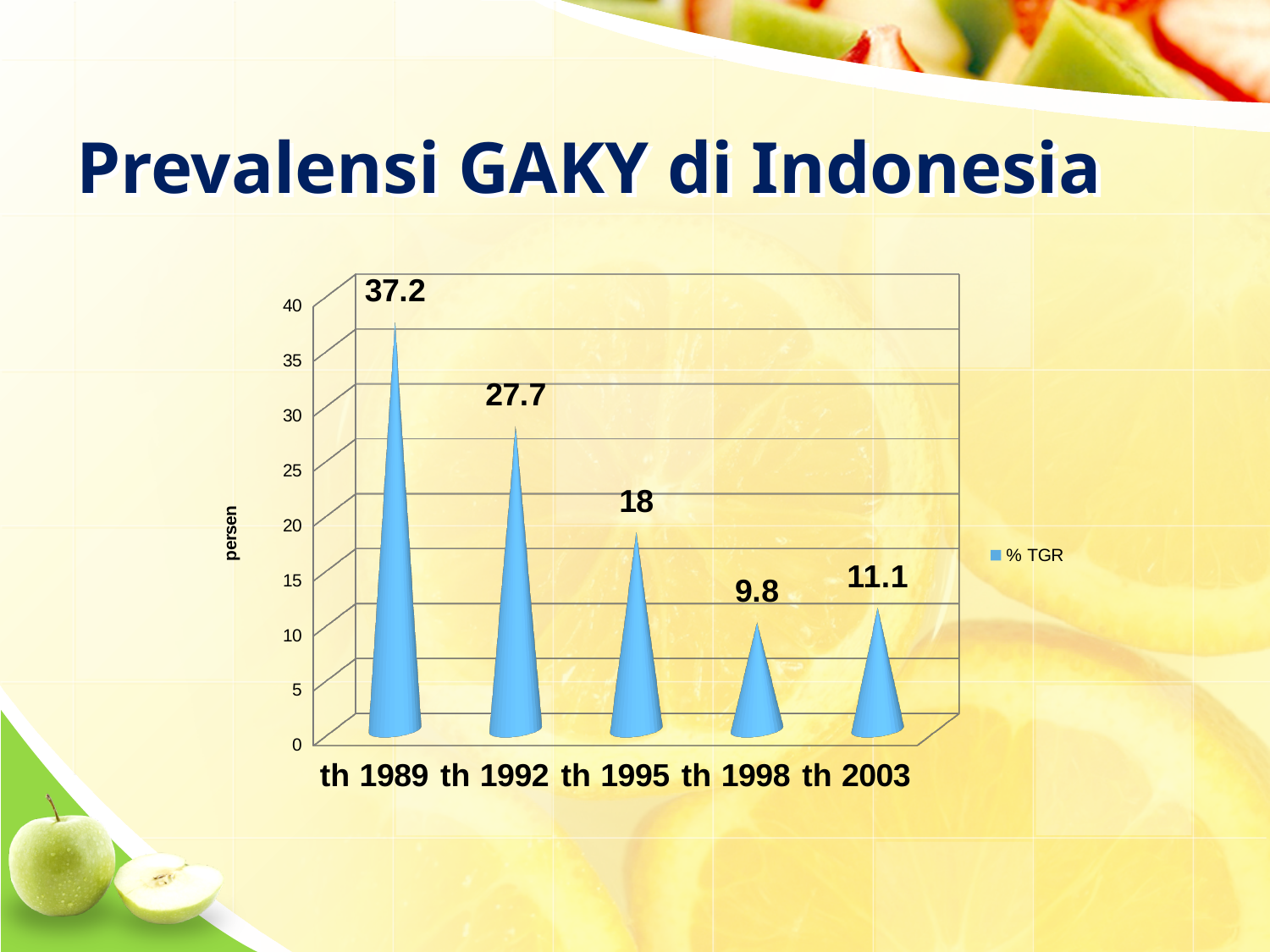
Which year has the highest % TGR value? th 1989 How many years are shown on the x axis of the chart? 5 What is the % TGR value for th 2003? 11.1 What is the label on the vertical axis of the chart? persen What is the % TGR value for th 1995? 18 What is the difference between the % TGR values for th 1989 and th 1992? 9.5 How many series does the legend list? 1 What kind of chart is shown on the slide? bar chart What is the % TGR value for th 1989? 37.2 Which year has the lowest % TGR value? th 1998 What is the difference between the % TGR values for th 2003 and th 1998? 1.3 Which is larger, the % TGR value for th 1992 or for th 1995? th 1992